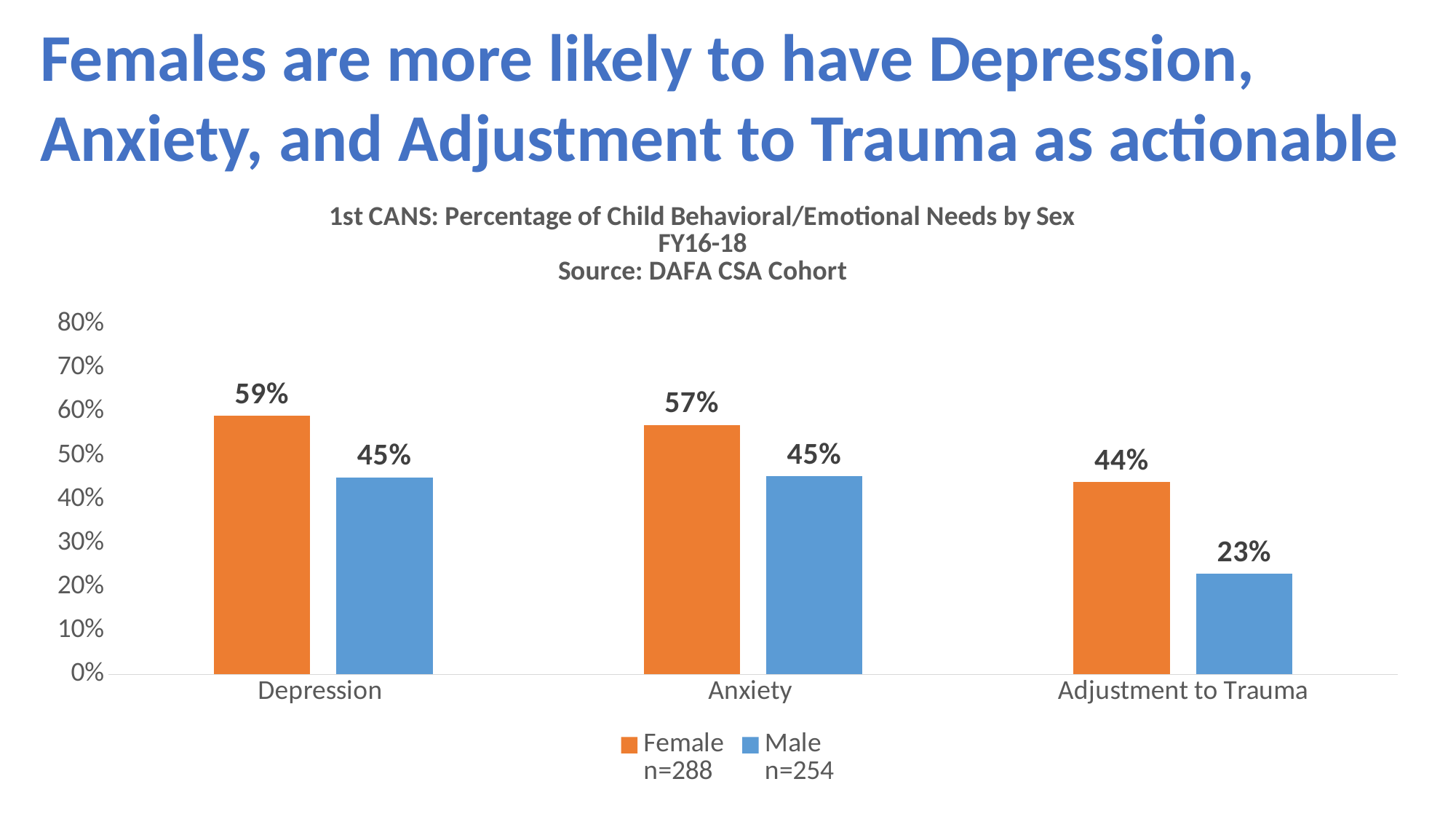
What kind of chart is shown on the slide? Bar chart Which is larger for Anxiety, the Female value or the Male value? Female What is the difference between the Female and Male values for Adjustment to Trauma? 21% What percentage of males have Adjustment to Trauma as an actionable need? 23% How many series does the legend list? 2 How many categories are shown on the x axis? 3 Which category has the lowest Male value? Adjustment to Trauma Which category has the highest Female value? Depression What is the sample size (n) for the Female group shown in the legend? n=288 What is the difference between the Female and Male values for Depression? 14% What is the Male value for Anxiety? 45% What percentage of females have Depression as an actionable need? 59%